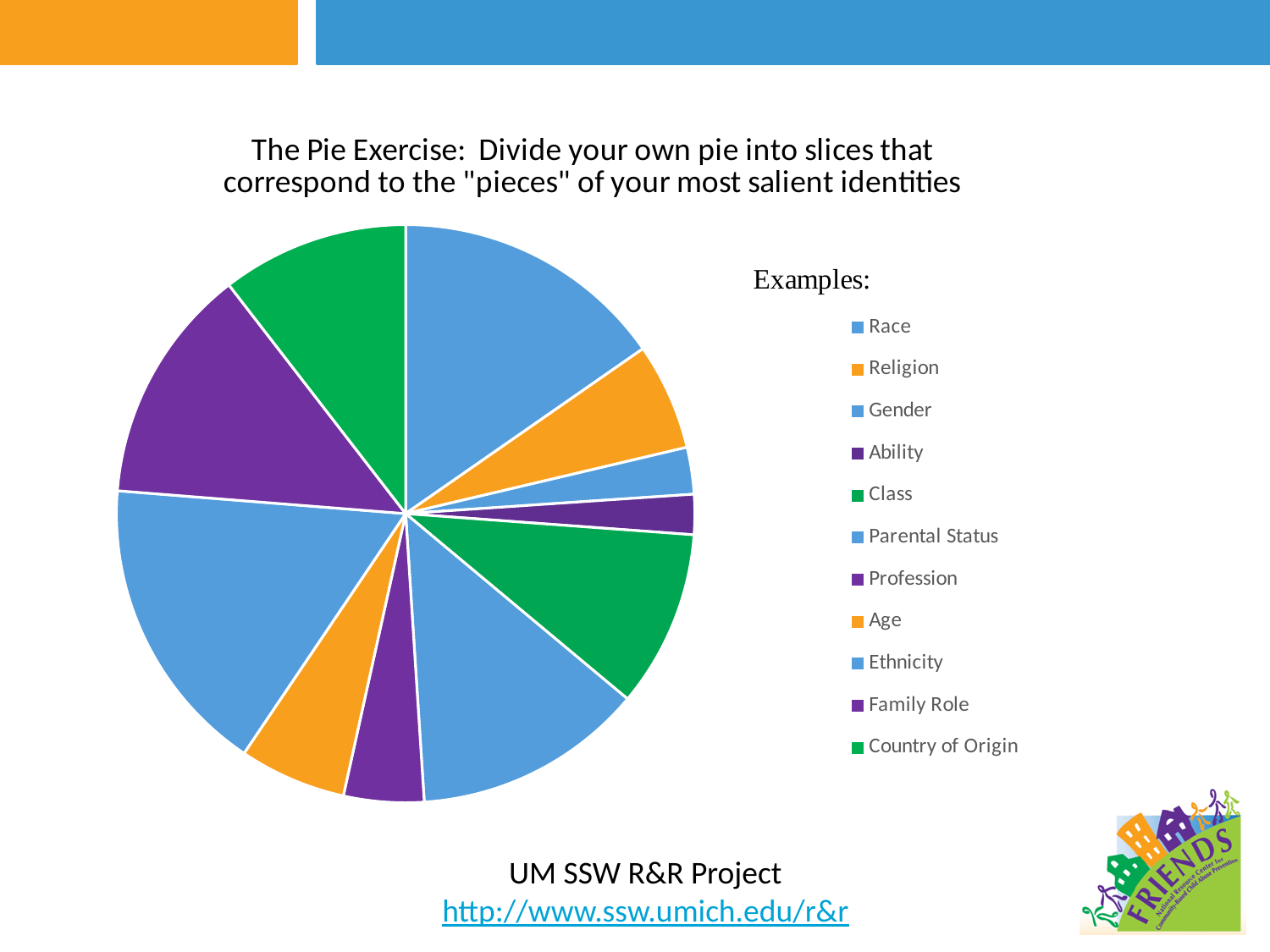
Which is larger in the pie chart, the slice for Religion or the slice for Ability? Religion What is the last entry listed in the pie chart's legend? Country of Origin How many slices does the pie chart have? 11 What is the first entry listed in the pie chart's legend? Race How many entries does the legend of the pie chart list? 11 Which is larger in the pie chart, the slice for Family Role or the slice for Profession? Family Role What kind of chart is shown on the slide? pie chart Which is larger in the pie chart, the slice for Class or the slice for Ability? Class